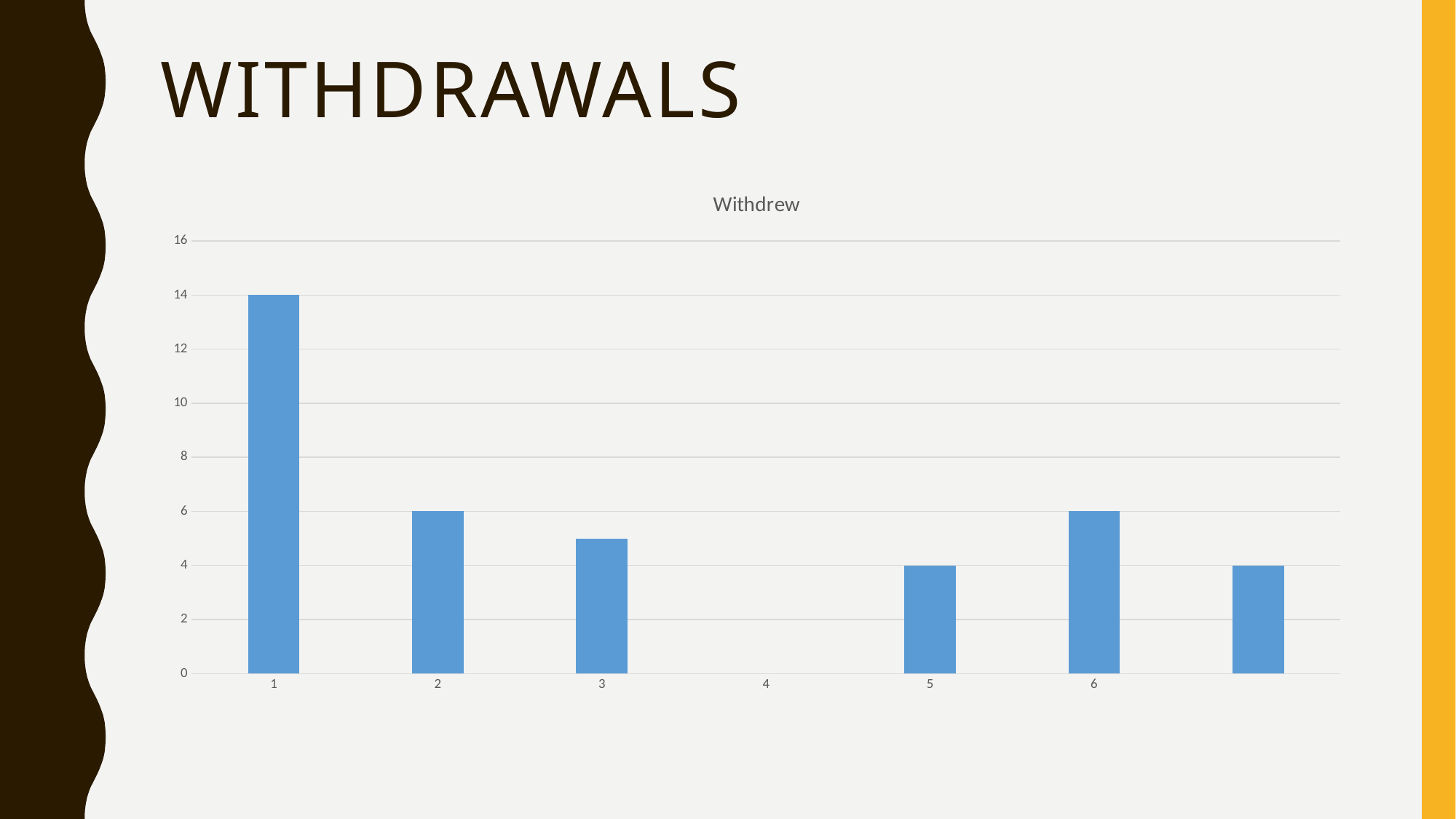
Which category has the highest value? 1 What is the title of the chart? Withdrew What kind of chart is shown on the slide? bar chart What is the value for category 1? 14 What is the value for category 2? 6 What is the value for category 5? 4 What is the value for category 6? 6 Which is larger, the value for category 2 or the value for category 5? category 2 What is the difference between the values for category 1 and category 5? 10 What is the difference between the values for category 1 and category 2? 8 Is the value for category 3 greater or less than 4? greater Is the value for category 3 greater or less than 6? less